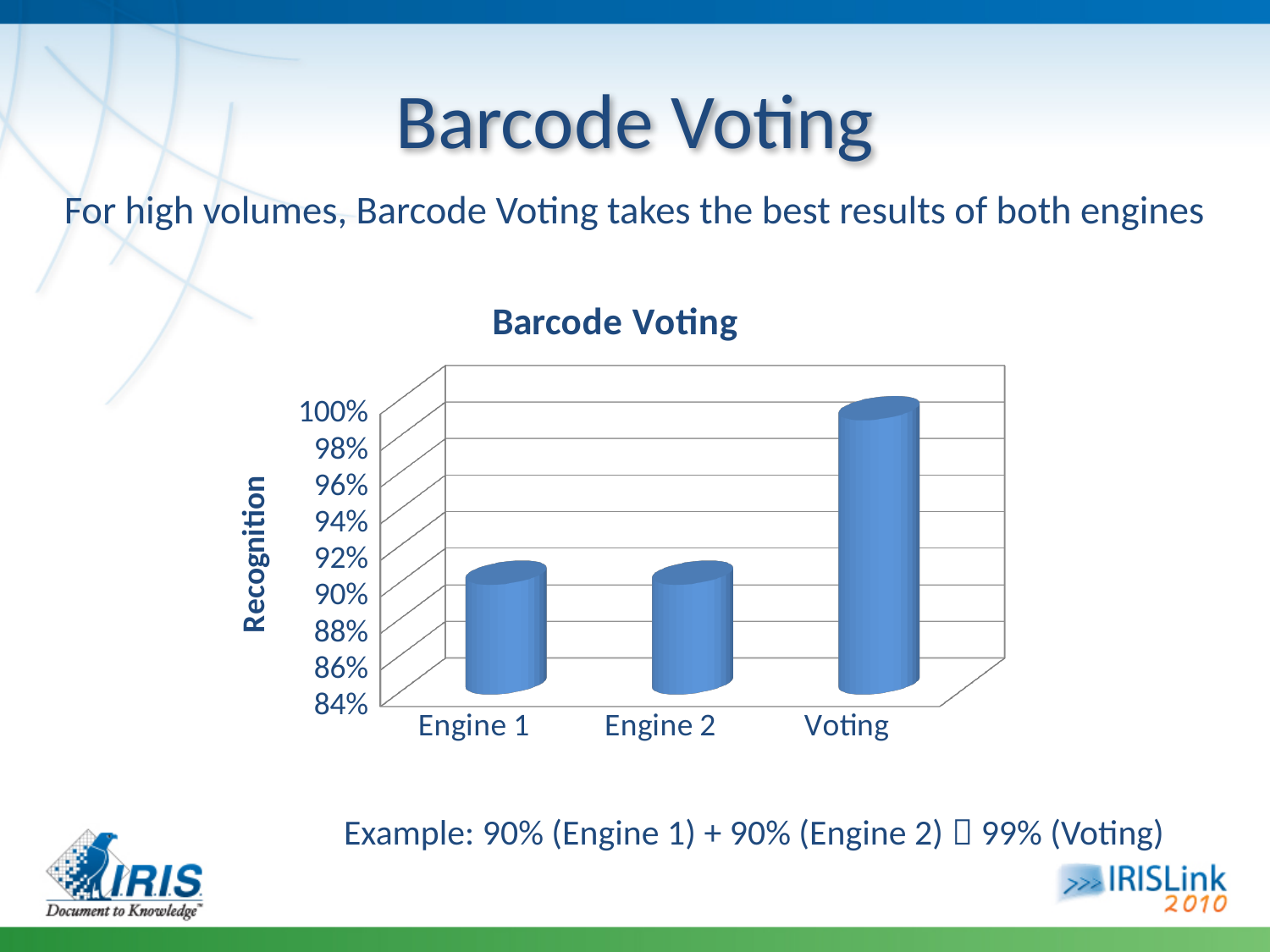
How many categories are plotted on the chart? 3 Is the value for Engine 1 greater or less than 94%? less What is the label of the vertical axis of the chart? Recognition Is the value for Voting greater or less than 96%? greater Using the values given in the example text, what is the difference between the Voting value and the Engine 2 value? 9% According to the example text on the slide, what is the recognition value for Voting? 99% Is the value for Engine 2 greater or less than 86%? greater According to the example text on the slide, what is the recognition value for Engine 1? 90% What type of chart is shown on the slide? bar chart What is the title of the chart? Barcode Voting Which category has the highest recognition value? Voting Which is larger, the value for Voting or the value for Engine 2? Voting